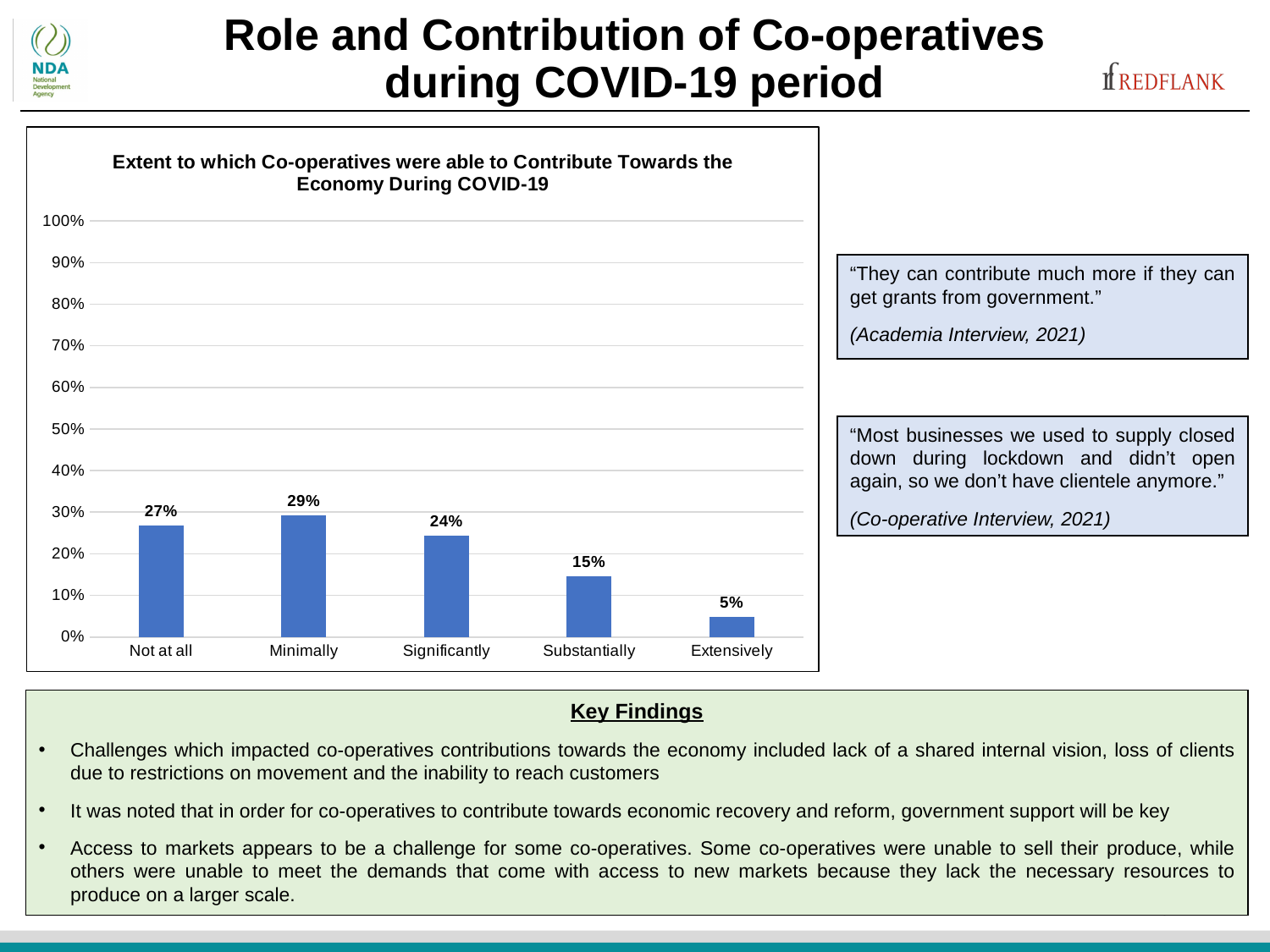
What kind of chart is shown on the slide? Bar chart What is the difference between the 'Significantly' and 'Substantially' values? 9% What is the title of the chart? Extent to which Co-operatives were able to Contribute Towards the Economy During COVID-19 Is the value for 'Substantially' greater or less than 20%? less How many categories are shown on the x axis of the chart? 5 What is the value shown for the 'Minimally' category? 29% Which category has the lowest value in the chart? Extensively Do the values generally rise or fall from 'Minimally' to 'Extensively' along the x axis? Fall What percentage of respondents said co-operatives were able to contribute 'Not at all' to the economy during COVID-19? 27% Which is larger, the value for 'Not at all' or the value for 'Significantly'? Not at all What is the value shown for the 'Extensively' category? 5% Which category has the highest value in the chart? Minimally